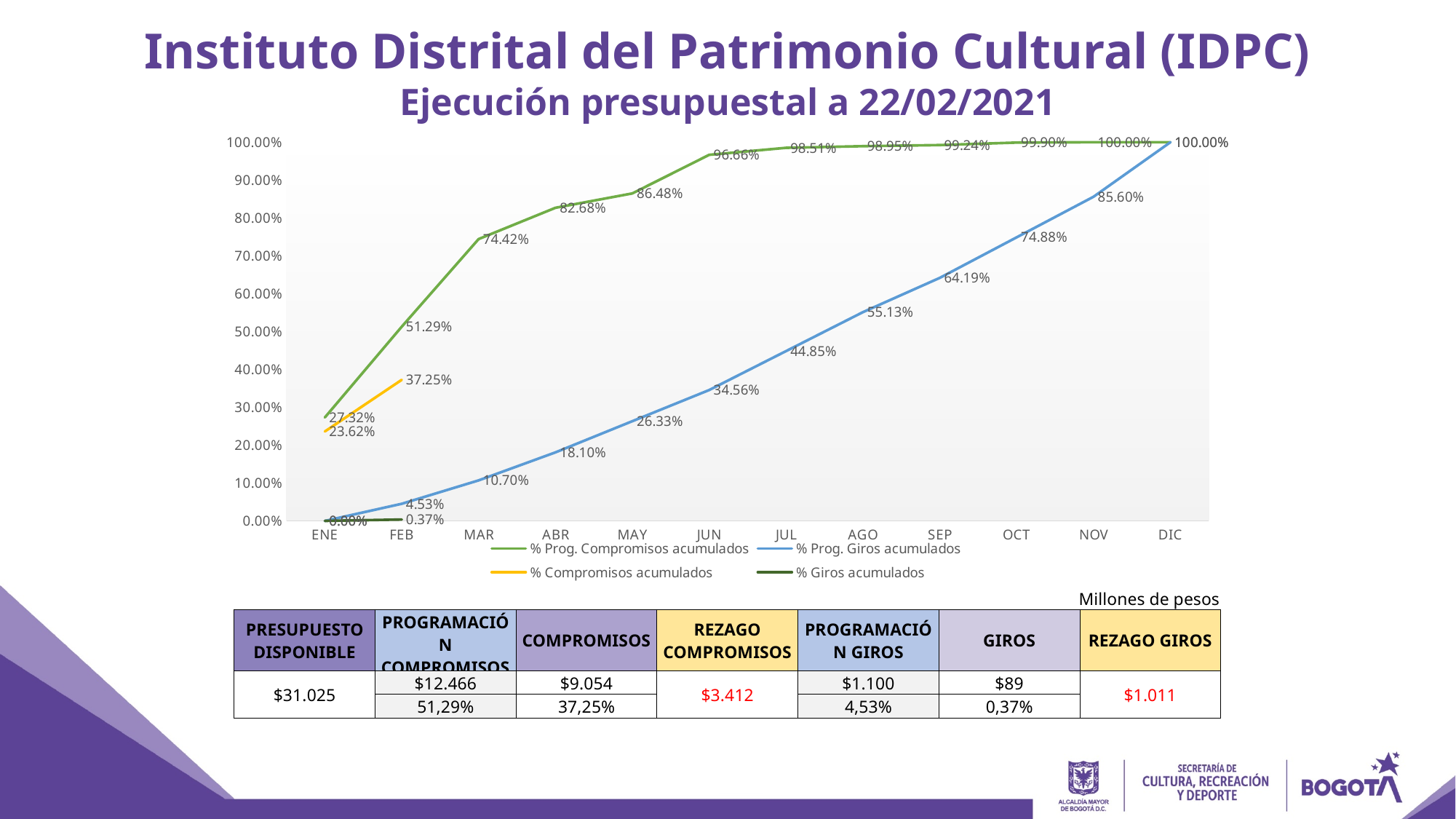
What is the value of % Giros acumulados for FEB? 0.37% In which month does % Prog. Giros acumulados reach its highest value? DIC What type of chart is shown on the slide? Line chart How many series does the chart legend list? 4 Which is larger in ENE: % Prog. Compromisos acumulados or % Compromisos acumulados? % Prog. Compromisos acumulados What is the difference between % Prog. Compromisos acumulados and % Compromisos acumulados in FEB? 14.04% What is the value of % Prog. Giros acumulados for AGO? 55.13% Does the % Prog. Giros acumulados series rise or fall from ENE to DIC? Rise What is the value of % Compromisos acumulados for FEB? 37.25% What is the value of % Prog. Compromisos acumulados for MAR? 74.42% Is the value of % Prog. Giros acumulados for JUN greater or less than 40.00%? less How many months are shown on the x axis of the chart? 12